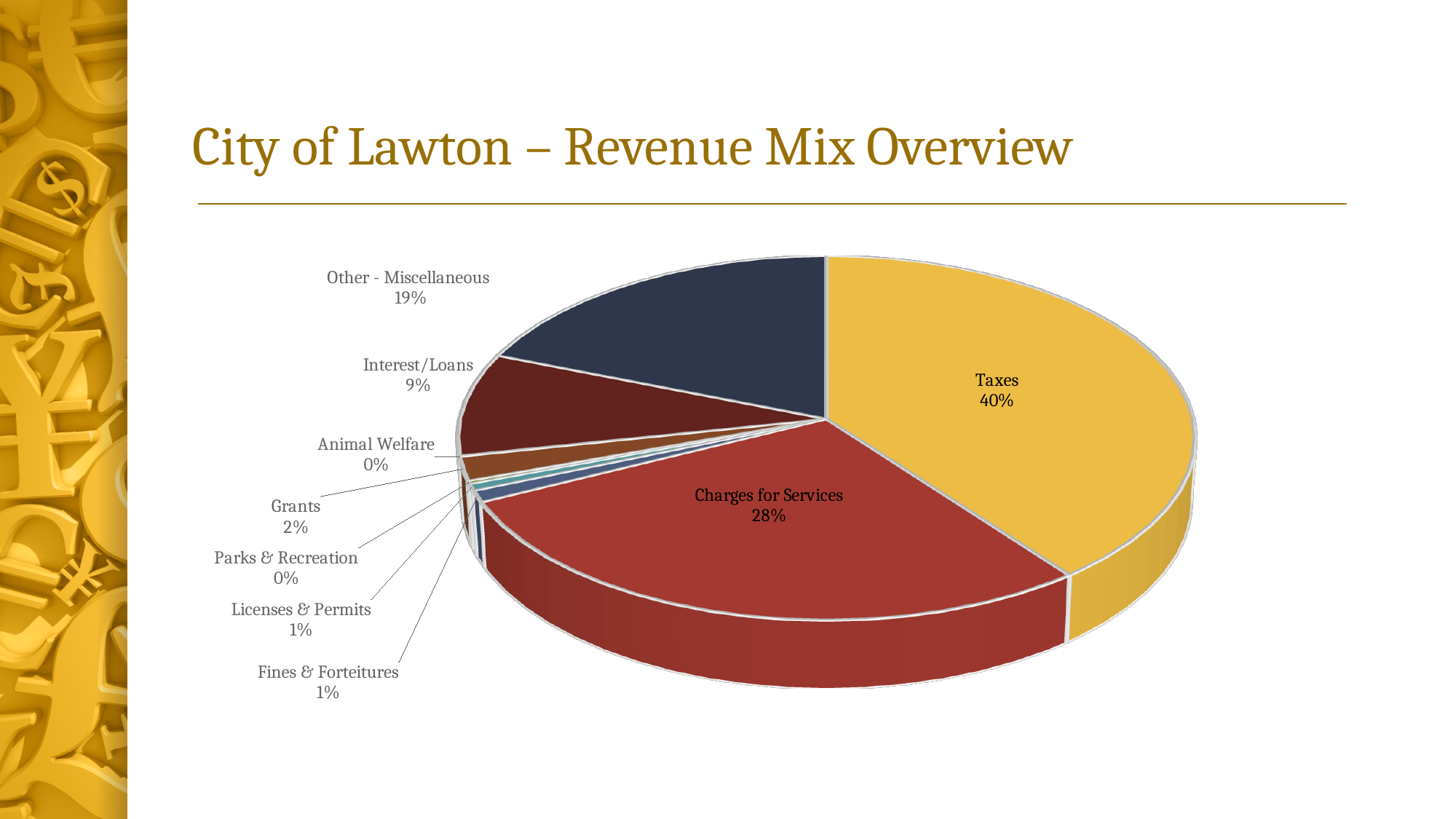
Which is larger, the share for Other - Miscellaneous or the share for Interest/Loans? Other - Miscellaneous What is the difference in percentage points between Taxes and Charges for Services? 12 What percentage is shown for Interest/Loans? 9% What kind of chart is shown on the slide? Pie chart What percentage is shown for Other - Miscellaneous? 19% What share of revenue comes from Charges for Services? 28% What percentage is shown for Animal Welfare? 0% What share of revenue comes from Taxes? 40% Which revenue category has the largest share of the pie? Taxes What percentage is shown for Grants? 2% How many revenue categories are labelled on the pie chart? 9 What is the title of the slide containing the chart? City of Lawton – Revenue Mix Overview